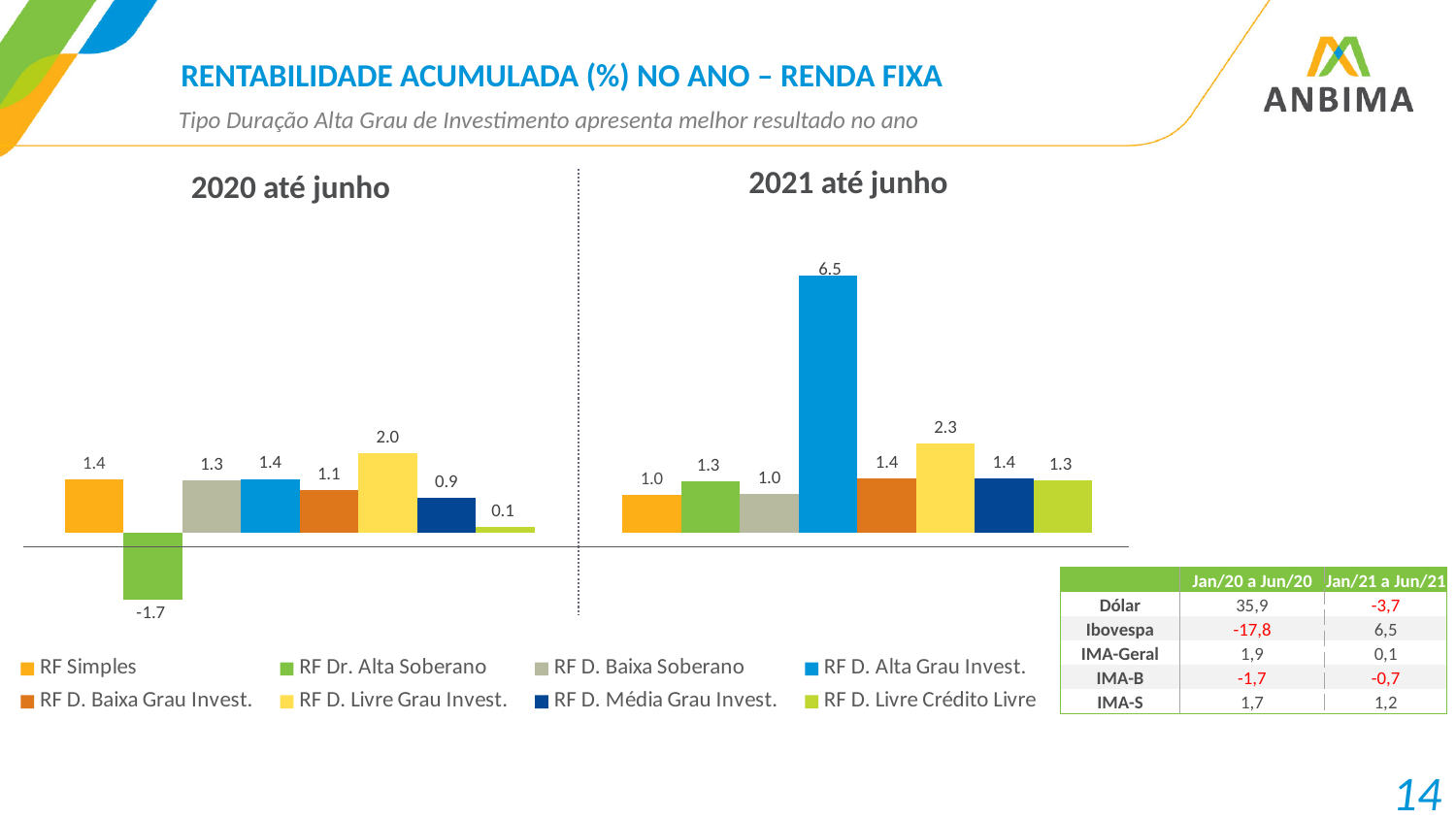
In the "2020 até junho" chart, what is the value for RF Dr. Alta Soberano? -1.7 What kind of chart is "2021 até junho"? Bar chart In the "2021 até junho" chart, which series has the highest value? RF D. Alta Grau Invest. In the "2020 até junho" chart, which series has the lowest value? RF Dr. Alta Soberano How many series does the legend list for the bar charts? 8 In the "2021 até junho" chart, what is the value for RF D. Alta Grau Invest.? 6.5 In the "2020 até junho" chart, what is the difference between RF Simples and RF D. Baixa Grau Invest.? 0.3 In the "2021 até junho" chart, what is the value for RF D. Livre Grau Invest.? 2.3 In the "2020 até junho" chart, which series has the highest value? RF D. Livre Grau Invest. In the "2020 até junho" chart, which is larger: RF D. Média Grau Invest. or RF D. Livre Crédito Livre? RF D. Média Grau Invest. In the "2021 até junho" chart, what is the difference between RF D. Alta Grau Invest. and RF D. Livre Grau Invest.? 4.2 In the "2020 até junho" chart, what is the value for RF D. Livre Grau Invest.? 2.0